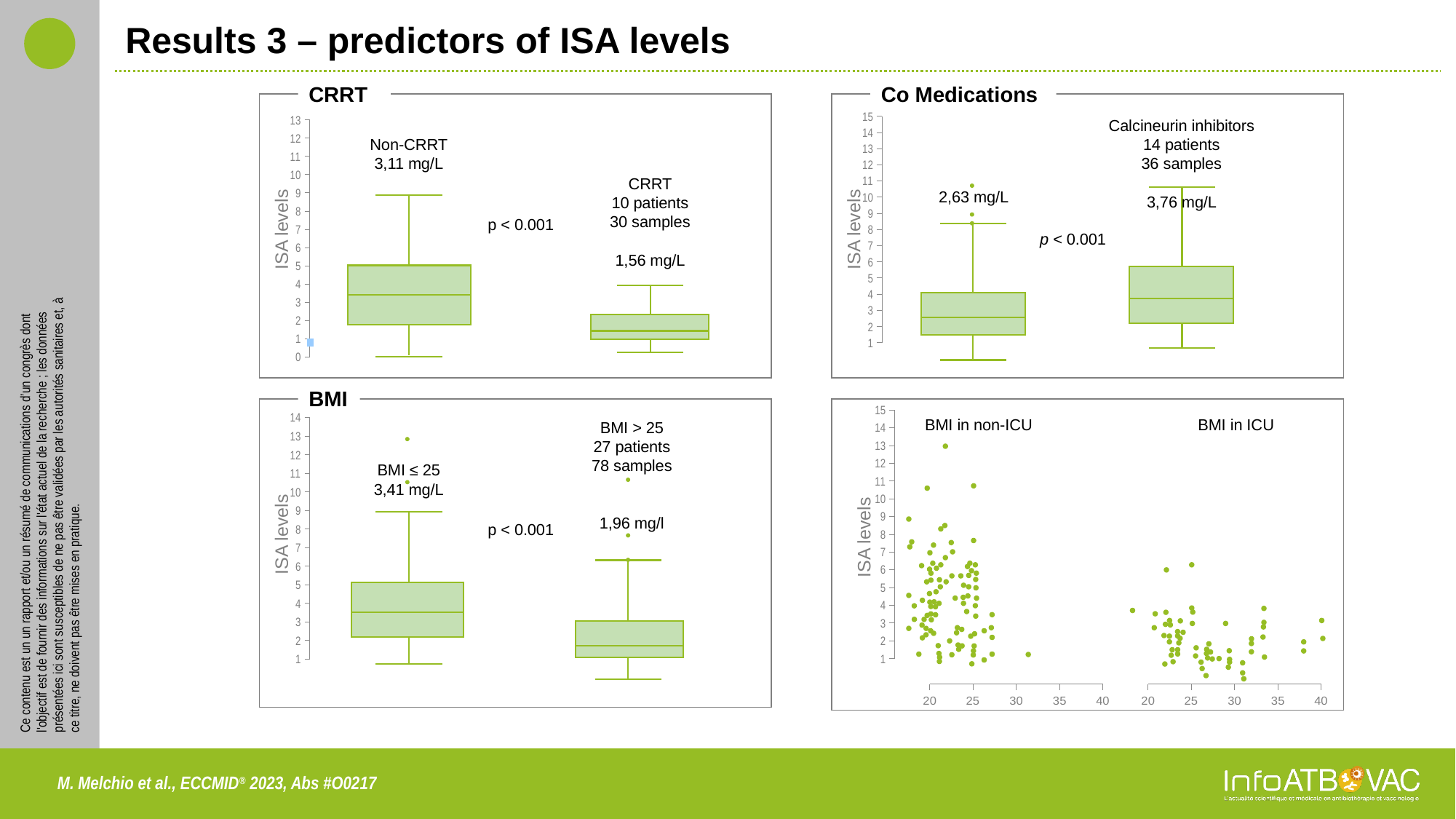
In the CRRT chart, how many patients and samples are reported for the CRRT group? 10 patients, 30 samples In the bottom-right scatter chart, is the highest ISA level point in the BMI in non-ICU panel greater or less than 12? greater In the BMI chart, what is the difference between the BMI ≤ 25 value and the BMI > 25 value? 1,45 mg/L In the CRRT chart, what is the difference between the Non-CRRT value and the CRRT value? 1,55 mg/L In the Co Medications chart, which group has the higher printed value: the group at 2,63 mg/L or the Calcineurin inhibitors group? Calcineurin inhibitors In the Co Medications chart, what is the ISA level value printed for the Calcineurin inhibitors group? 3,76 mg/L In the CRRT chart, what is the ISA level value printed for the CRRT group? 1,56 mg/L In the Co Medications chart, how many samples are reported for the Calcineurin inhibitors group? 36 samples What kind of chart is the bottom-right chart showing BMI in non-ICU and BMI in ICU? Scatter plot In the CRRT chart, what is the ISA level value printed for the Non-CRRT group? 3,11 mg/L In the BMI chart, what is the ISA level value printed for the BMI ≤ 25 group? 3,41 mg/L In the BMI chart, what p-value is printed between the two groups? p < 0.001